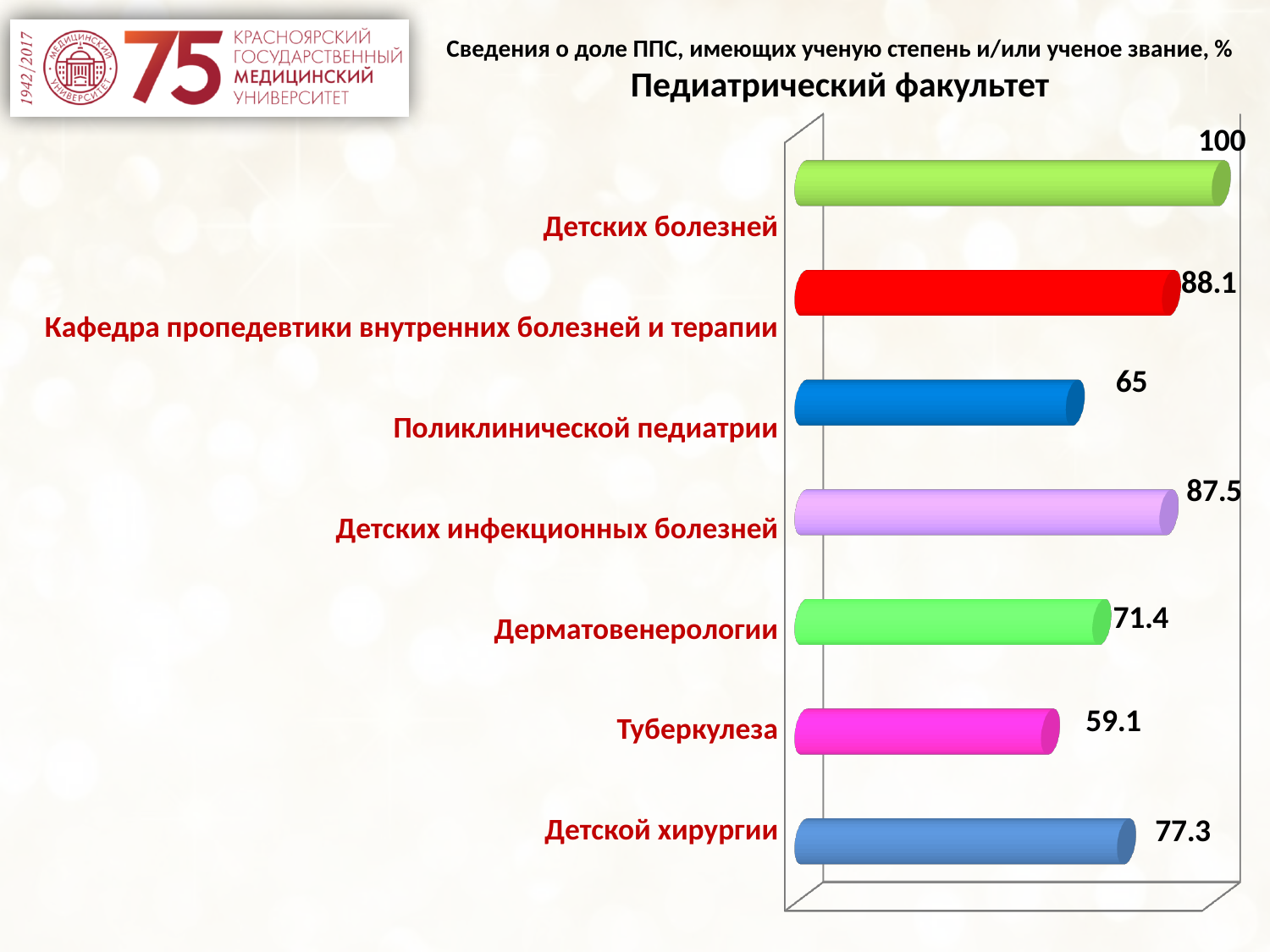
What kind of chart is shown on the slide? Bar chart Which is larger, the value for Дерматовенерологии or the value for Детской хирургии? Детской хирургии What is the value for Туберкулеза? 59.1 What colour is the bar for Кафедра пропедевтики внутренних болезней и терапии? Red Which category has the lowest value? Туберкулеза What is the value for Кафедра пропедевтики внутренних болезней и терапии? 88.1 What is the value for Детской хирургии? 77.3 Which category has the highest value? Детских болезней What is the title of the chart? Педиатрический факультет How many categories are shown in the chart? 7 What is the difference between the values for Детских инфекционных болезней and Поликлинической педиатрии? 22.5 What is the value for Детских болезней? 100